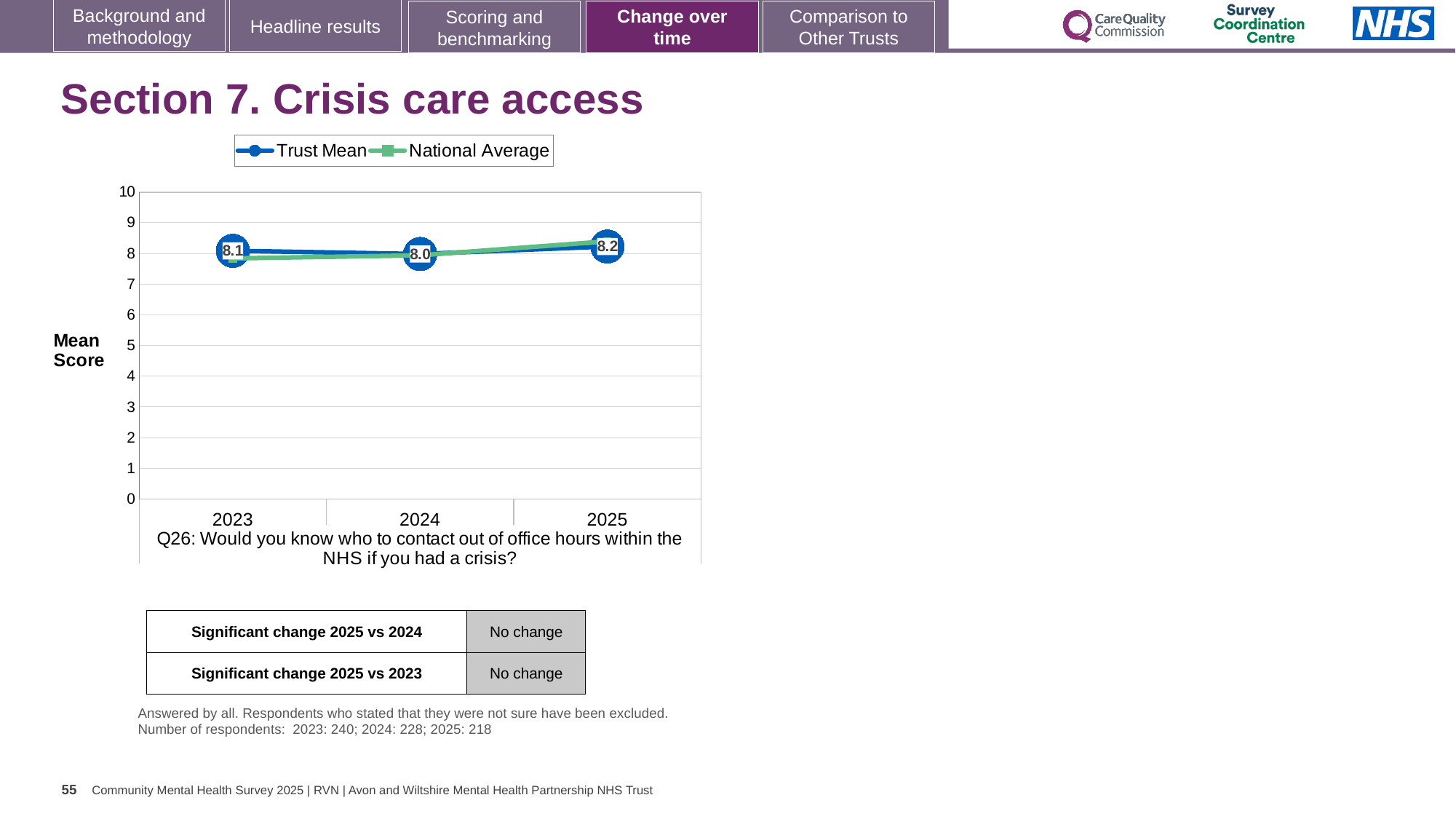
How many years are shown on the x axis of the chart? 3 What is the Trust Mean value for 2024? 8.0 Is the National Average value for 2024 greater or less than 5? greater What kind of chart is shown on the slide? Line chart What is the Trust Mean value for 2023? 8.1 What is the Trust Mean value for 2025? 8.2 Does the Trust Mean rise or fall from 2024 to 2025? Rise Which year has the larger Trust Mean, 2023 or 2025? 2025 How many series does the chart legend list? 2 In which year is the Trust Mean lowest? 2024 What is the difference between the Trust Mean in 2025 and in 2024? 0.2 In which year is the Trust Mean highest? 2025